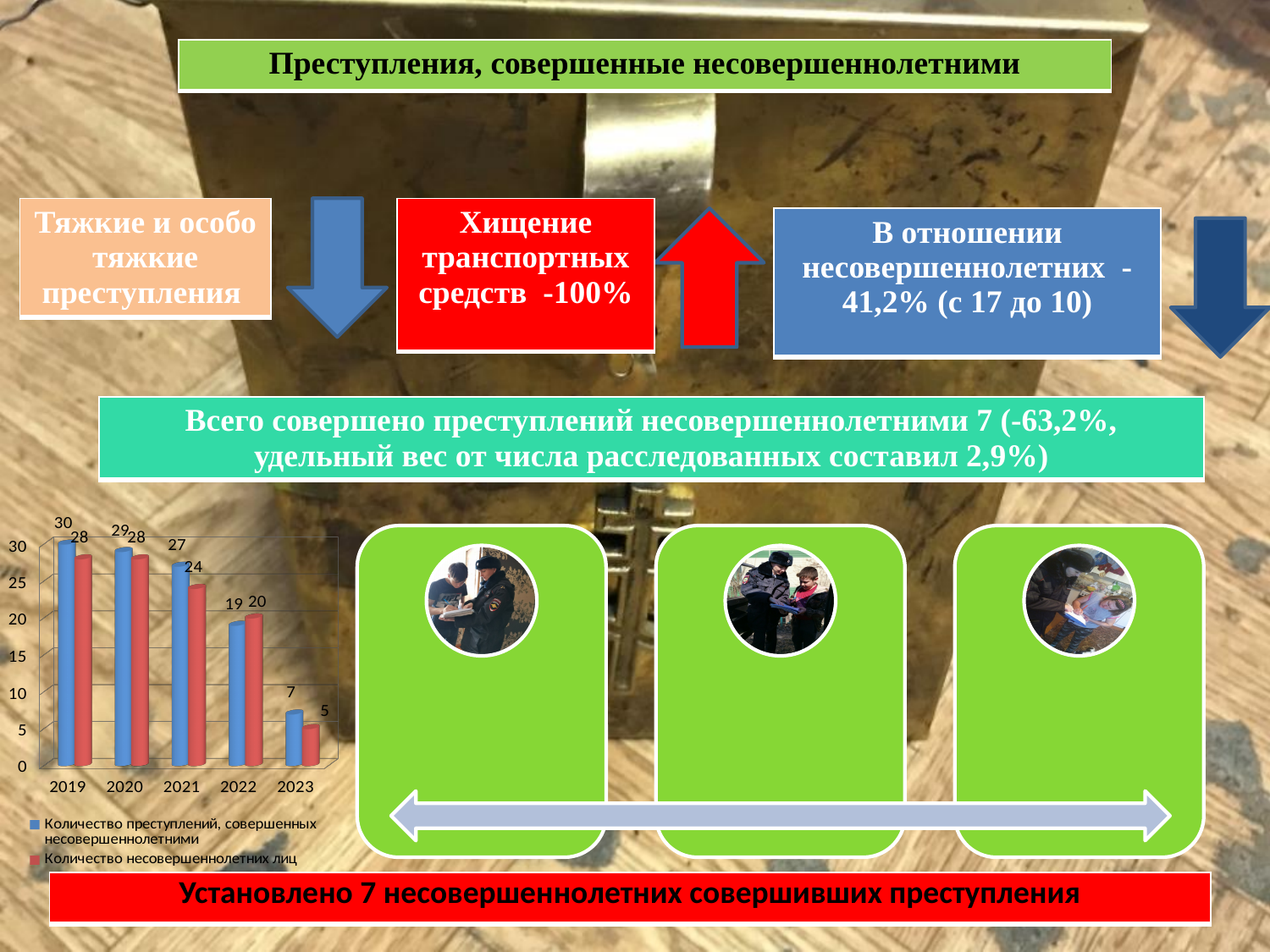
Какого типа диаграмма показана на слайде? Столбчатая (bar chart) Как изменяется количество преступлений, совершенных несовершеннолетними, с 2019 по 2023 год? Снижается Какое количество несовершеннолетних лиц показано на диаграмме за 2021 год? 24 В каком году количество преступлений, совершенных несовершеннолетними, было наибольшим? 2019 Какое количество преступлений, совершенных несовершеннолетними, показано за 2023 год? 7 В каком году количество несовершеннолетних лиц было наименьшим? 2023 Сколько рядов данных указано в легенде диаграммы? 2 Какое количество преступлений, совершенных несовершеннолетними, показано на диаграмме за 2019 год? 30 Что больше в 2022 году: количество преступлений, совершенных несовершеннолетними, или количество несовершеннолетних лиц? Количество несовершеннолетних лиц Каким цветом на диаграмме показан ряд «Количество несовершеннолетних лиц»? Красным На сколько количество преступлений, совершенных несовершеннолетними, в 2022 году меньше, чем в 2021 году? 8 Сколько лет (категорий) показано на диаграмме? 5